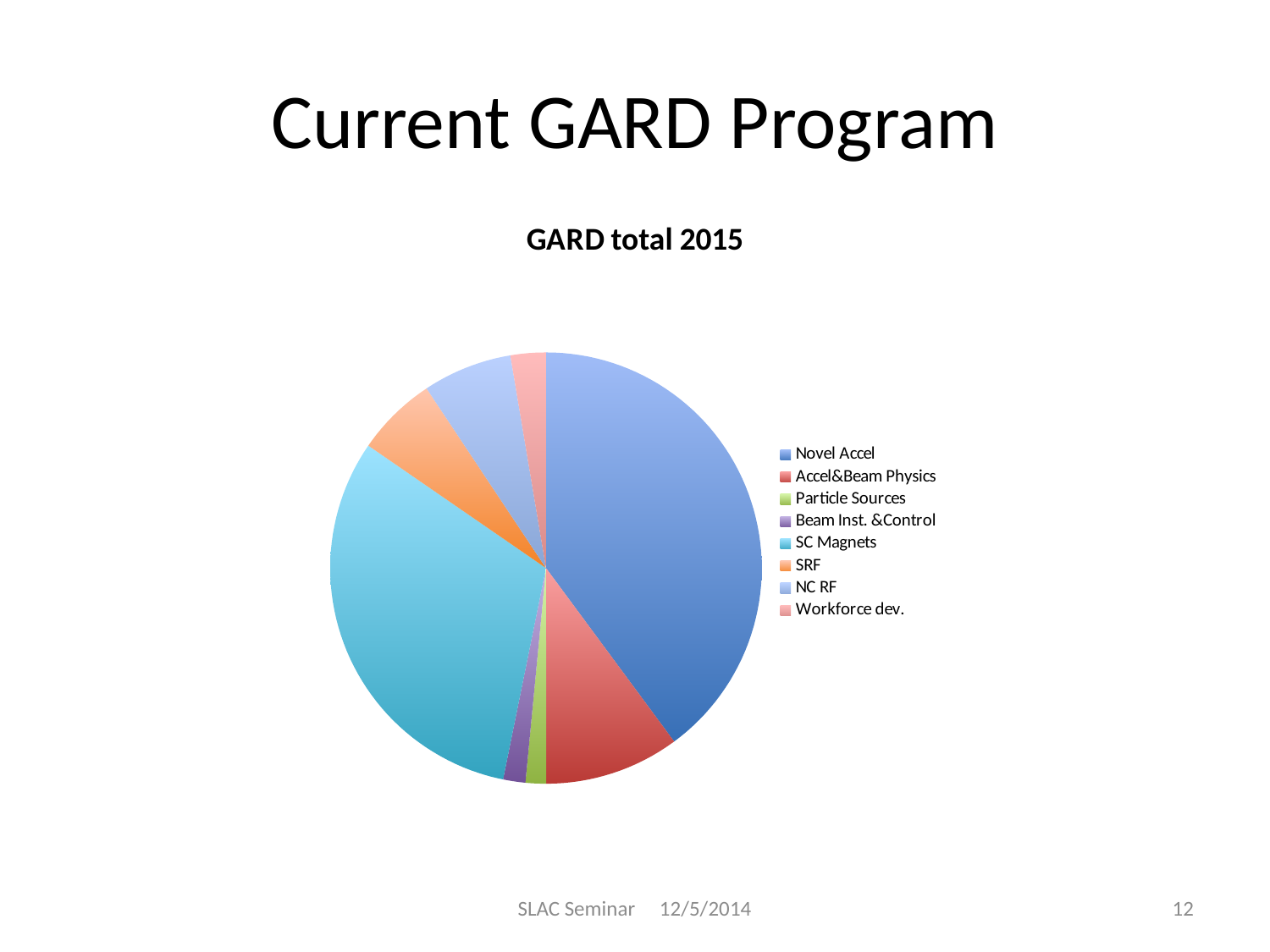
Which slice is larger, Accel&Beam Physics or NC RF? Accel&Beam Physics How many categories (slices) does the pie chart have? 8 Which slice is larger, Novel Accel or Accel&Beam Physics? Novel Accel What kind of chart is shown on the slide? pie chart What colour is the Novel Accel slice in the pie chart? blue How many entries does the chart legend list? 8 Which slice is larger, Novel Accel or SC Magnets? Novel Accel Which category has the largest slice of the pie? Novel Accel What is the title of the chart? GARD total 2015